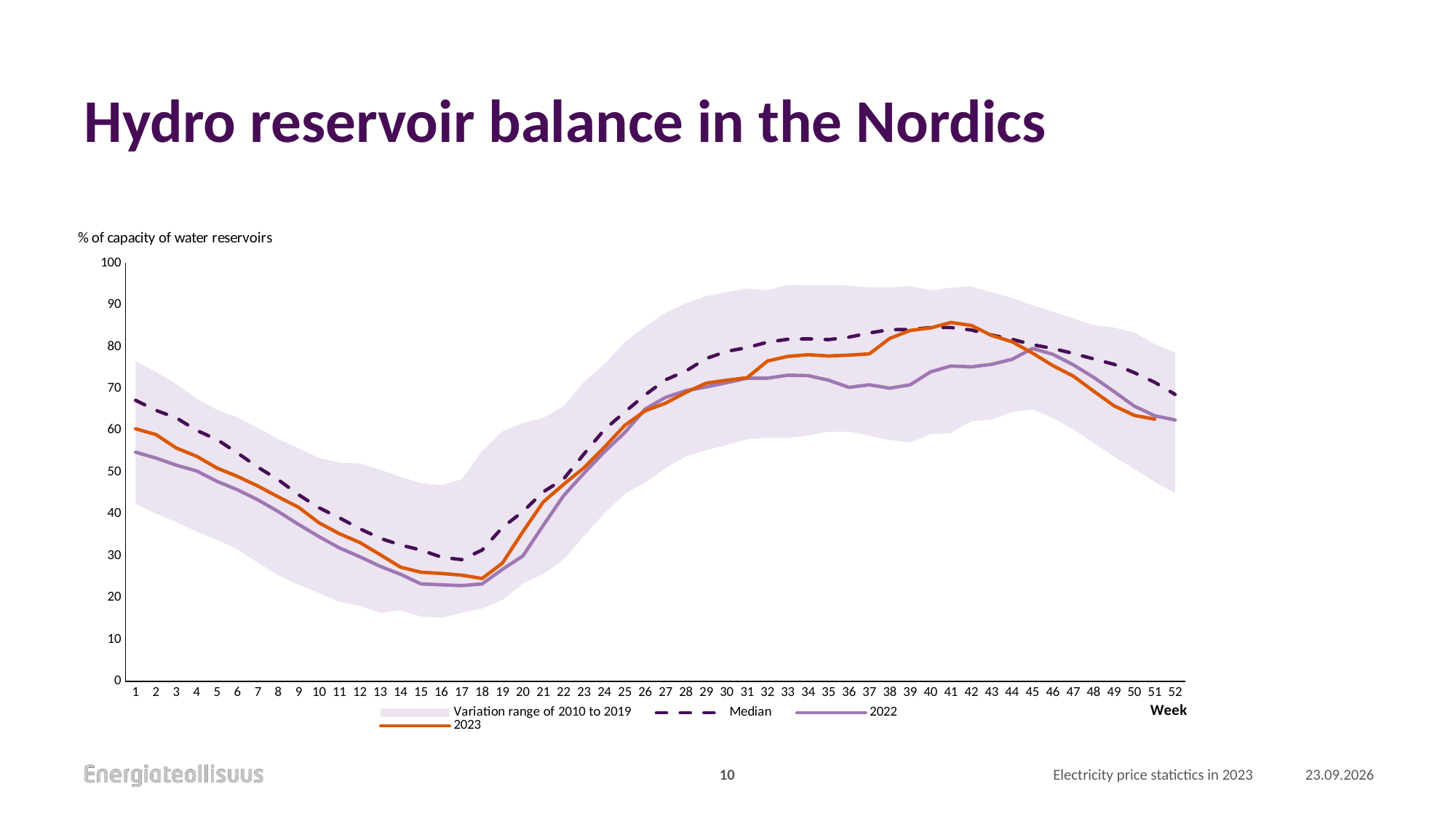
At week 1, which is higher: the 2023 line or the 2022 line? 2023 Does the 2023 line rise or fall from week 1 to week 18? fall What is the label on the y axis of the chart? % of capacity of water reservoirs Is the Median value at week 17 greater or less than 40? less Is the 2023 value at week 1 greater or less than 50? greater Is the 2023 value at week 18 greater or less than 30? less What kind of chart is shown on the slide? line chart How many series does the legend list? 4 How many weeks are shown on the x axis? 52 At week 36, which is higher: the 2023 line or the 2022 line? 2023